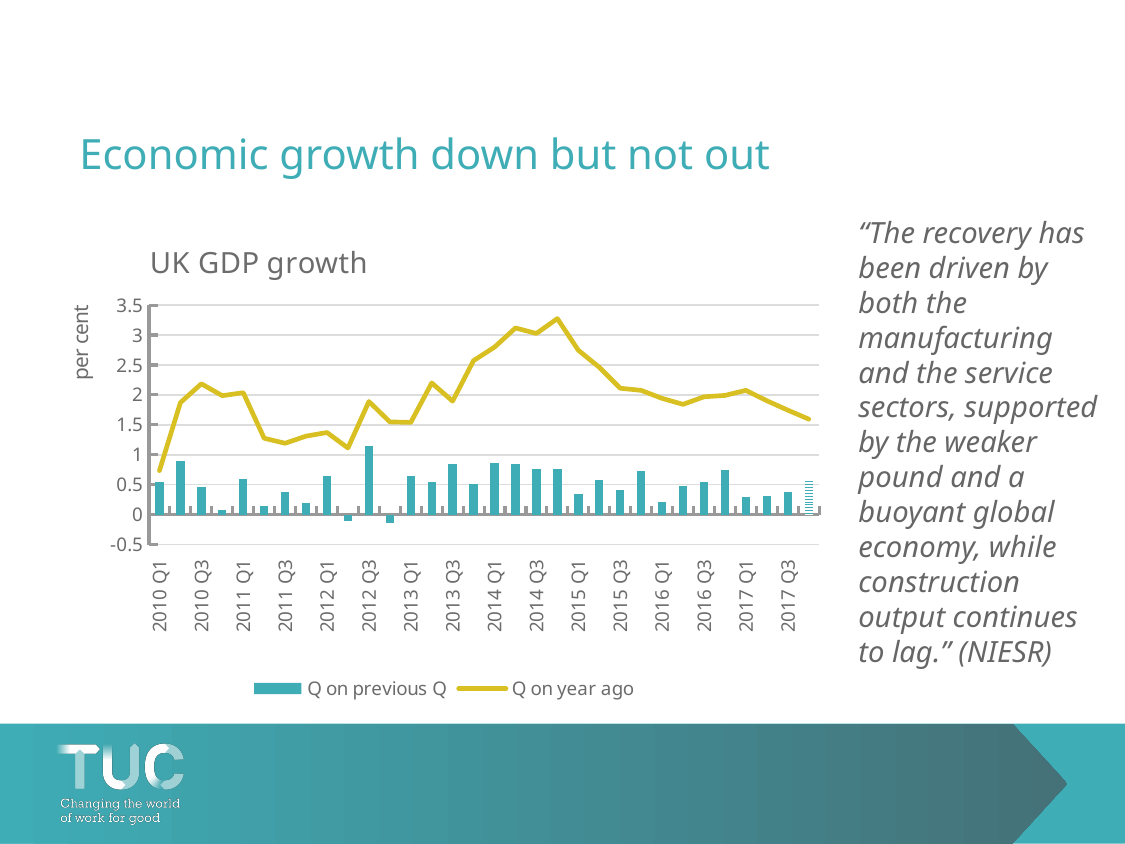
Is the 'Q on previous Q' bar for 2017 Q1 greater or less than 0.5? less What are the two series named in the legend of the chart? Q on previous Q and Q on year ago Does the 'Q on year ago' line rise or fall between 2014 Q3 and 2017 Q3? Fall Is the 'Q on year ago' value for 2017 Q3 greater or less than 2? less How many series does the legend of the UK GDP growth chart list? 2 What kind of chart is shown on the slide? A combined bar and line chart What is the label on the vertical axis of the chart? per cent Which is larger: the 'Q on year ago' value for 2014 Q3 or for 2017 Q3? 2014 Q3 Is the 'Q on year ago' value for 2010 Q1 greater or less than 1? less In which quarter does the 'Q on year ago' line reach its highest value? 2014 Q4 How many 'Q on previous Q' bars fall below zero? 2